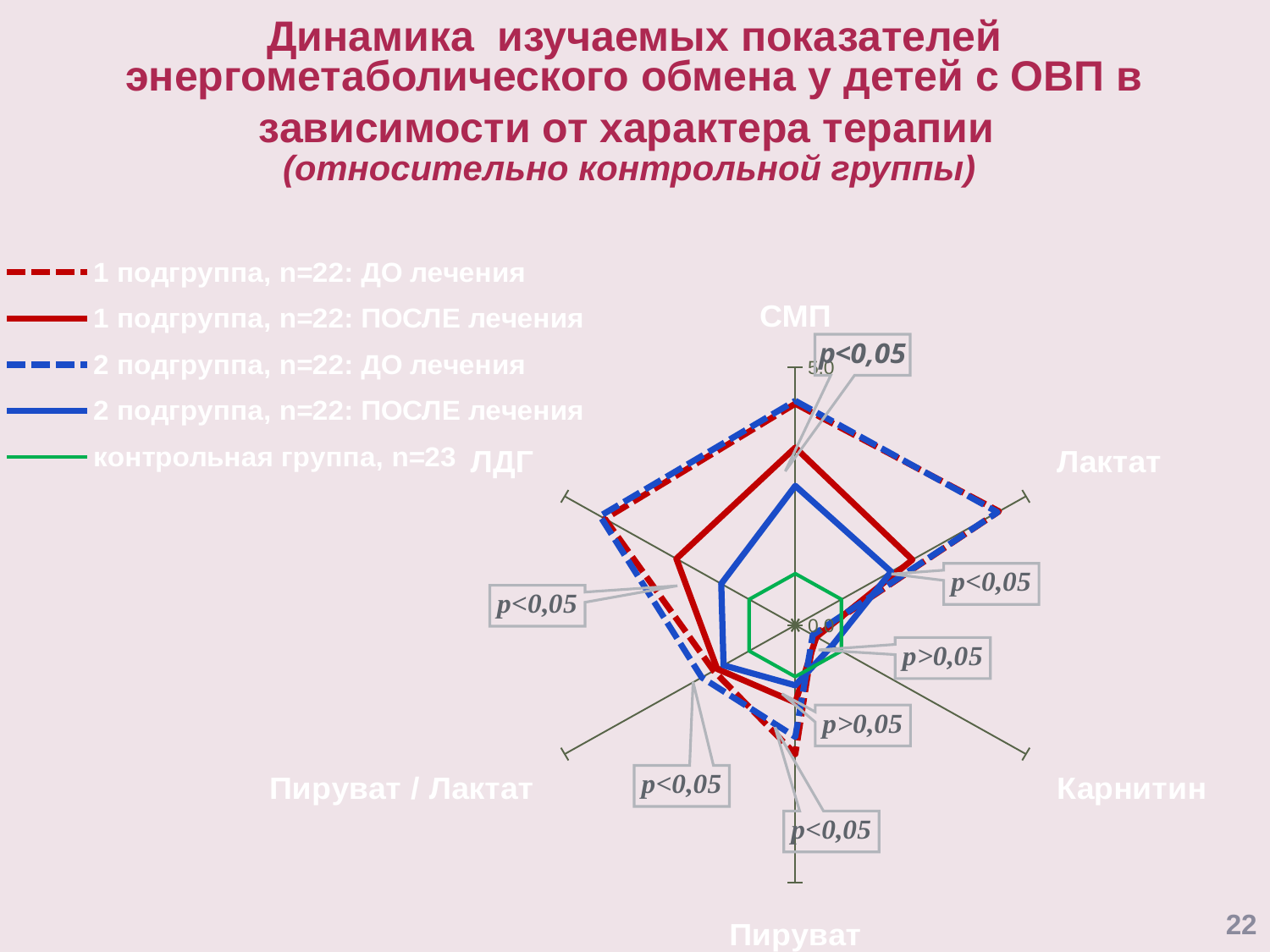
For СМП, which is larger: the value for '1 подгруппа, n=22: ДО лечения' or '1 подгруппа, n=22: ПОСЛЕ лечения'? 1 подгруппа, n=22: ДО лечения For ЛДГ, which is larger: the value for '2 подгруппа, n=22: ДО лечения' or '2 подгруппа, n=22: ПОСЛЕ лечения'? 2 подгруппа, n=22: ДО лечения How many axes (categories) does the radar chart have? 6 Which category has the lowest value for '1 подгруппа, n=22: ПОСЛЕ лечения'? Карнитин How many series does the legend list? 5 What is the maximum value shown on the radar chart's axis scale? 5.0 Is the value for Лактат for '2 подгруппа, n=22: ПОСЛЕ лечения' greater or less than 5.0? less What kind of chart is shown on the slide? Radar chart Which series is drawn in green on the chart? контрольная группа, n=23 For СМП, which is larger: the value for '1 подгруппа, n=22: ПОСЛЕ лечения' or '2 подгруппа, n=22: ПОСЛЕ лечения'? 1 подгруппа, n=22: ПОСЛЕ лечения Is the value for СМП for '1 подгруппа, n=22: ДО лечения' greater or less than 5.0? less